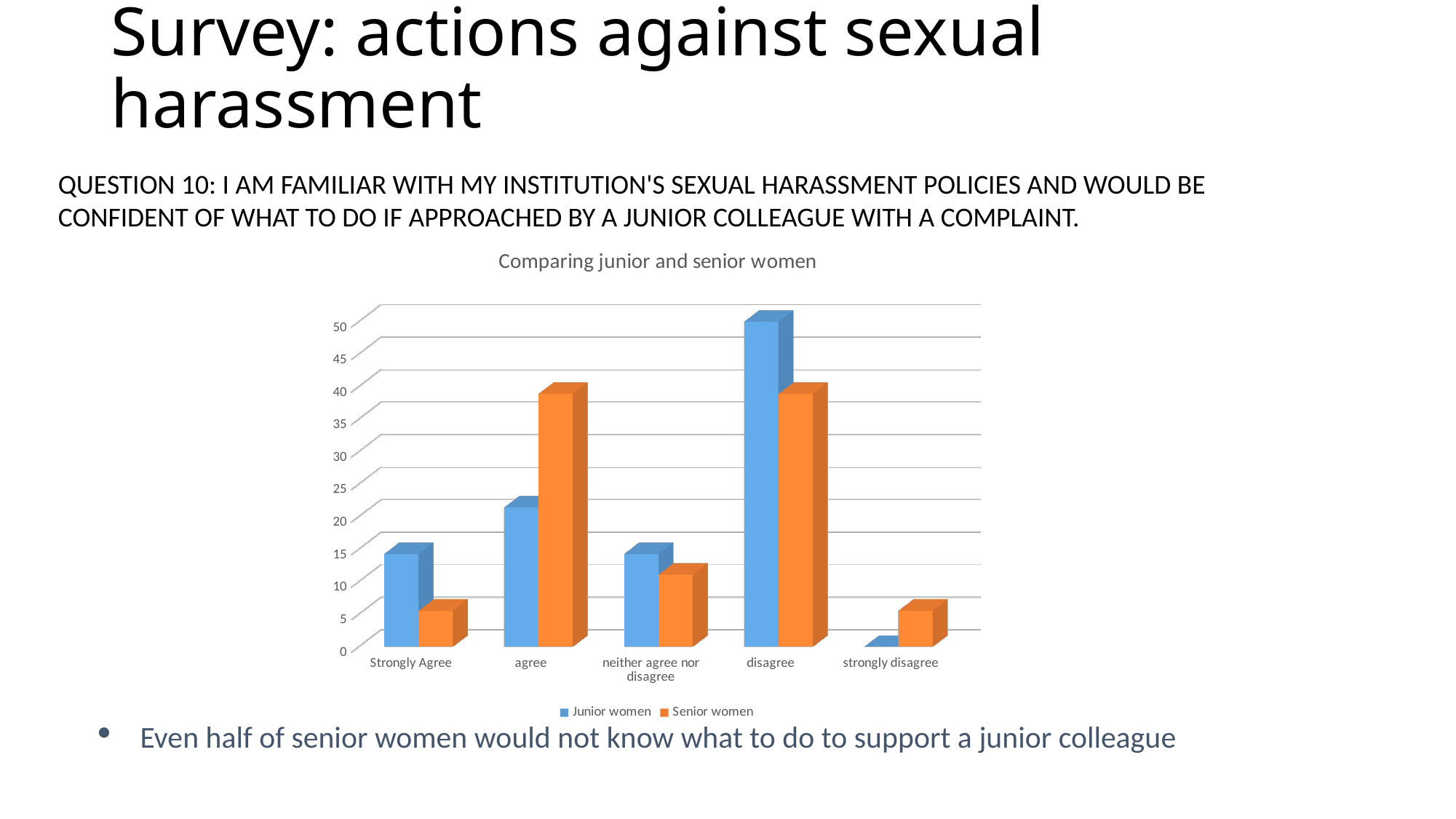
Which category has the highest value for Junior women? disagree Is the value for Senior women in the Strongly Agree category greater or less than 10? less Is the value for Senior women in the agree category greater or less than 35? greater Which colour represents Senior women in the chart? orange How many categories are shown on the x axis of the chart? 5 Which category has the lowest value for Junior women? strongly disagree What kind of chart is shown on the slide? bar chart Is the value for Junior women in the disagree category greater or less than 45? greater In the agree category, which series has the larger value, Junior women or Senior women? Senior women What is the title of the chart? Comparing junior and senior women How many series does the chart's legend list? 2 In the Strongly Agree category, which series has the larger value, Junior women or Senior women? Junior women